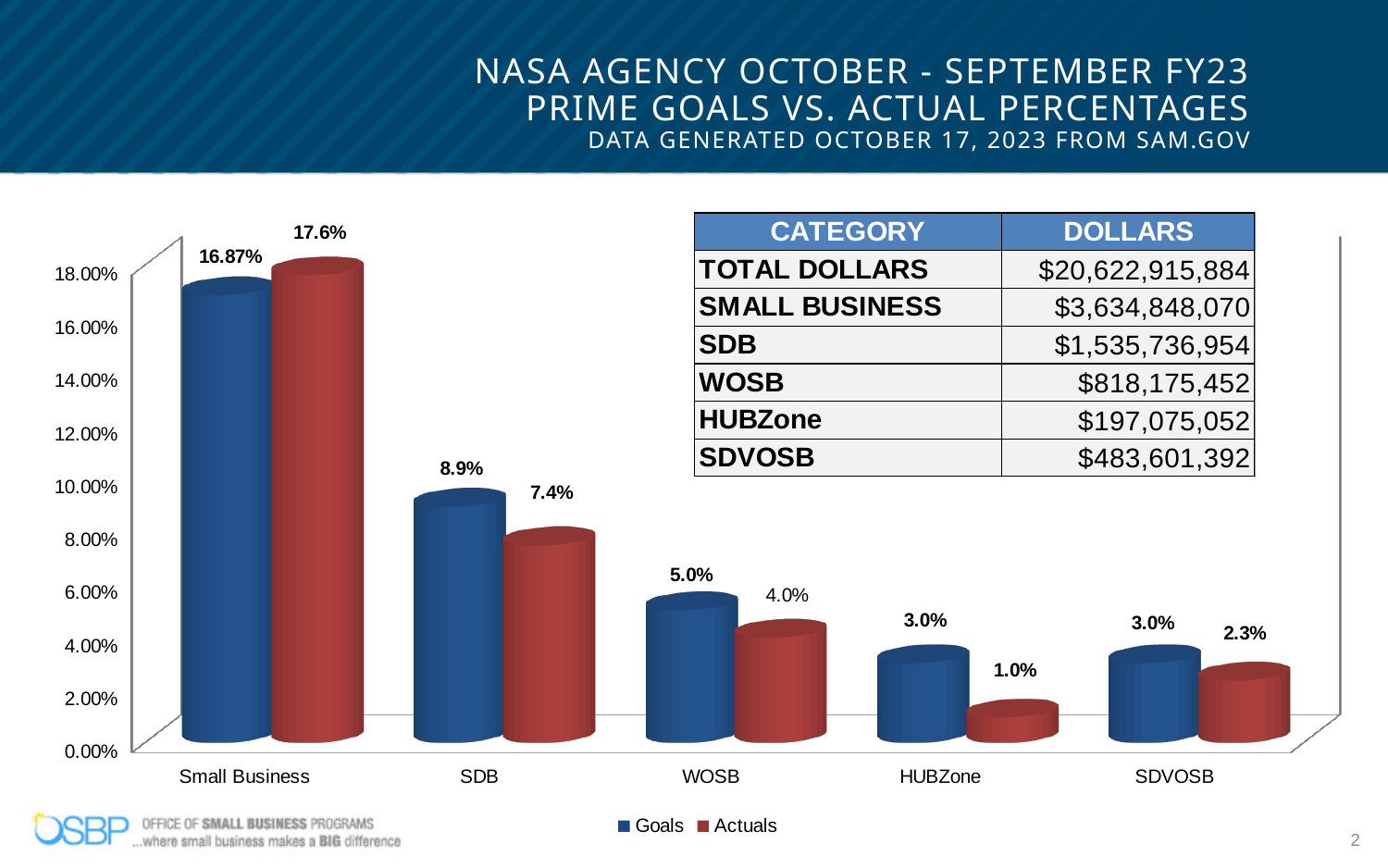
What kind of chart is shown on the slide? bar chart What is the difference between the Goals and Actuals values for SDVOSB? 0.7% Which is larger for Small Business, the Goals value or the Actuals value? Actuals Is the Actuals value for WOSB greater or less than 6.00%? less What is the Goals value for WOSB? 5.0% How many categories are shown on the x axis of the chart? 5 Which category has the highest Actuals value? Small Business What is the Actuals value for SDB? 7.4% What is the Actuals value for HUBZone? 1.0% Which category has the lowest Actuals value? HUBZone How many series does the chart legend list? 2 What is the Goals value for Small Business? 16.87%